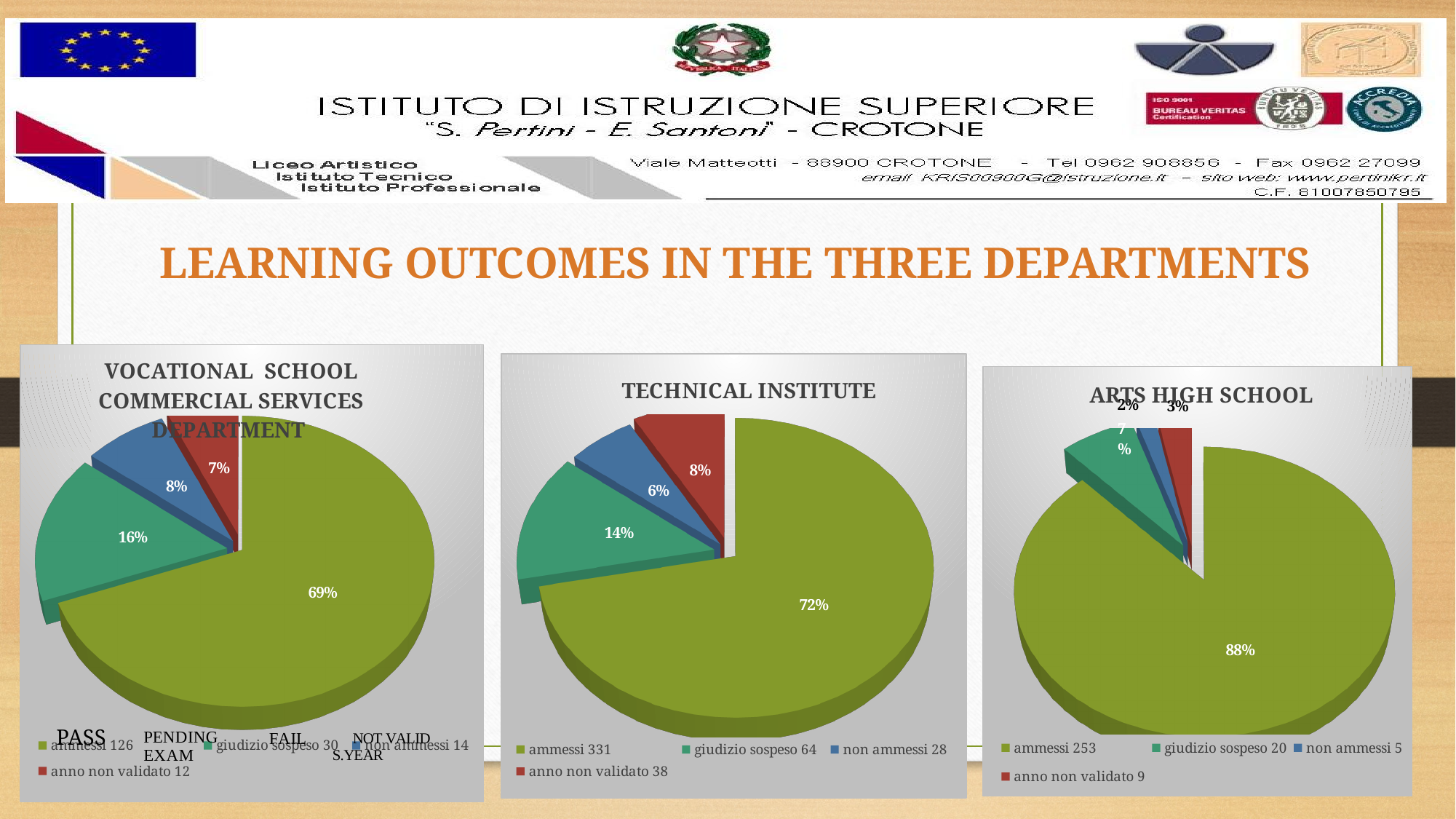
What is the title of the slide above the three pie charts? LEARNING OUTCOMES IN THE THREE DEPARTMENTS In the Arts High School chart, what share of the pie is the largest slice? 88% What kind of chart is the Technical Institute chart? pie chart In the Technical Institute chart, which legend category has the smallest slice? non ammessi 28 In the Technical Institute chart, what share of the pie is the 'ammessi' slice? 72% In the Arts High School chart, what percentage is shown for the 'anno non validato' slice? 3% In the Technical Institute chart, what is the difference in percentage points between the 'ammessi' slice and the 'giudizio sospeso' slice? 58 How many slices does the Vocational School Commercial Services Department pie chart have? 4 How many entries does the legend of the Arts High School chart list? 4 In the Vocational School Commercial Services Department chart, what percentage is shown for the 'giudizio sospeso' slice? 16% In the Vocational School Commercial Services Department chart, which is larger: the 'non ammessi' slice or the 'anno non validato' slice? non ammessi In the Arts High School chart, which legend category has the largest slice? ammessi 253